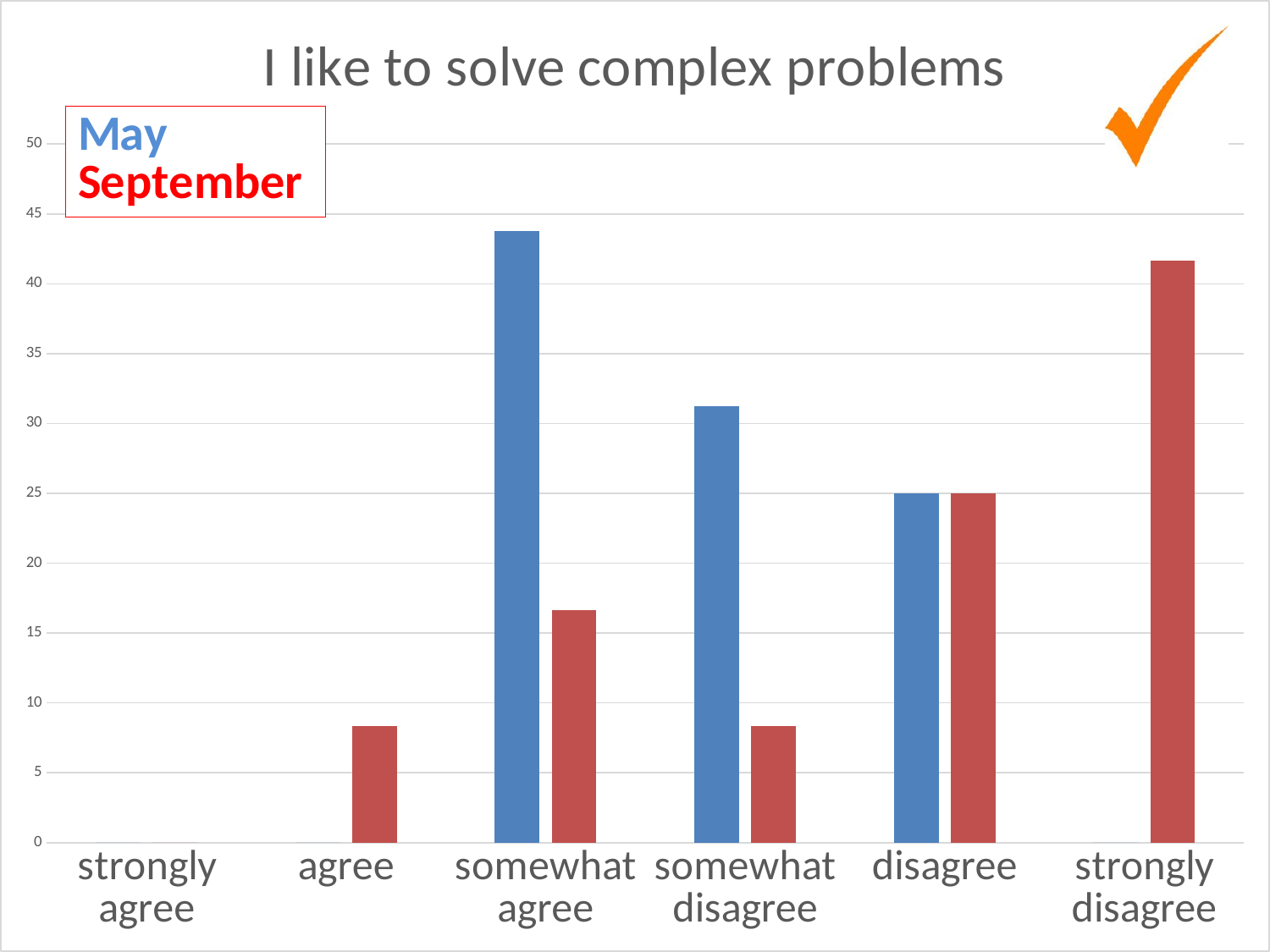
Which category has the highest value for September? strongly disagree Is the value for May in the somewhat disagree category greater or less than 30? greater Which category has the highest value for May? somewhat agree In the somewhat disagree category, which series has the larger value, May or September? May Is the value for May in the somewhat agree category greater or less than 40? greater How many series does the legend list? 2 What kind of chart is shown on the slide? bar chart Is the value for September in the somewhat agree category greater or less than 20? less What is the value for May in the disagree category? 25 What is the title of the chart? I like to solve complex problems How many response categories are shown on the x axis? 6